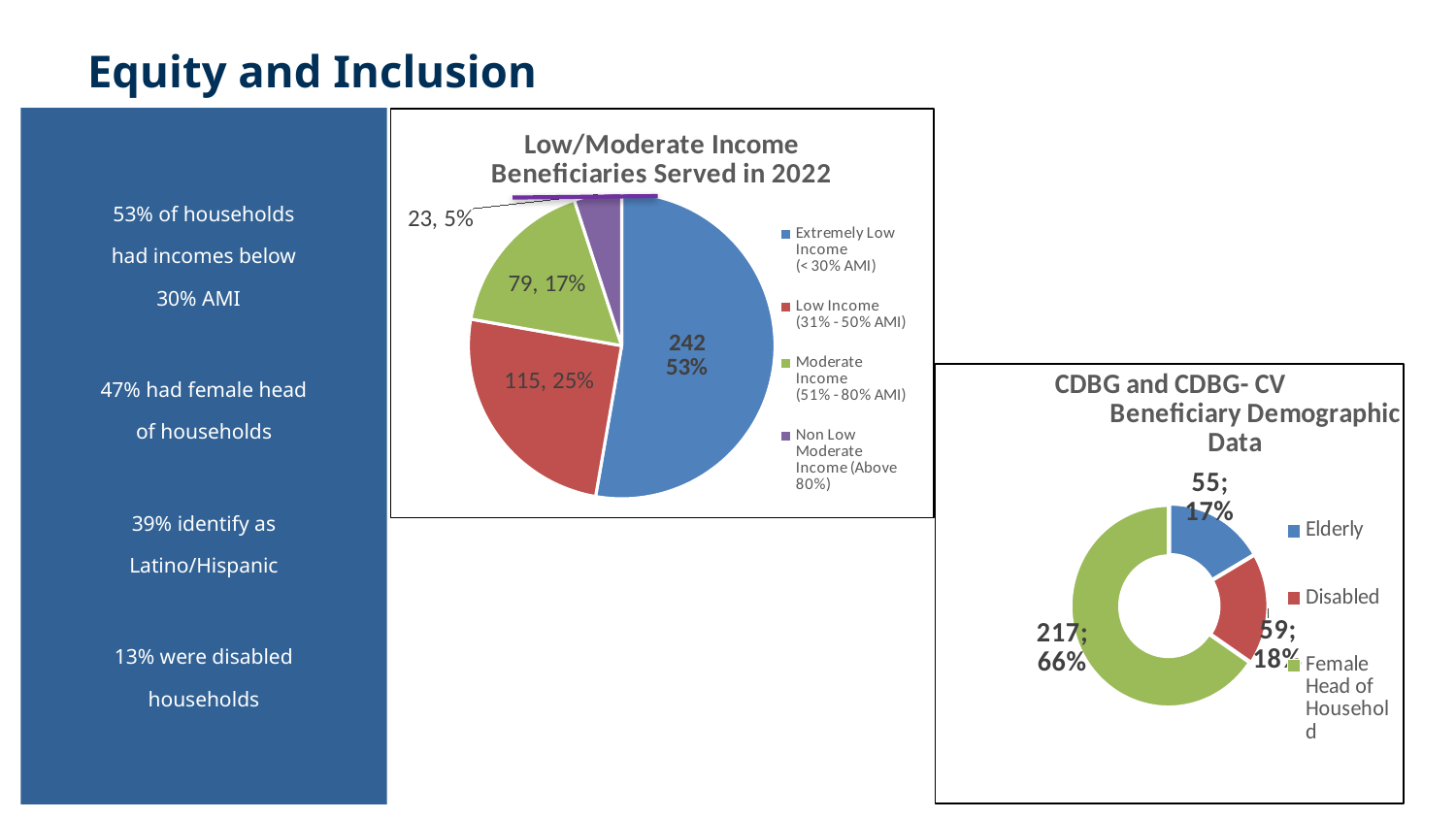
In the 'Low/Moderate Income Beneficiaries Served in 2022' chart, how many beneficiaries were Extremely Low Income (< 30% AMI)? 242 In the 'CDBG and CDBG-CV Beneficiary Demographic Data' chart, what percentage of beneficiaries are Elderly? 17% In the 'Low/Moderate Income Beneficiaries Served in 2022' chart, what is the difference between the number of Extremely Low Income and Low Income beneficiaries? 127 In the 'Low/Moderate Income Beneficiaries Served in 2022' chart, how many beneficiaries were Moderate Income (51% - 80% AMI)? 79 In the 'Low/Moderate Income Beneficiaries Served in 2022' chart, which income category has the smallest slice? Non Low Moderate Income (Above 80%) In the 'CDBG and CDBG-CV Beneficiary Demographic Data' chart, how many beneficiaries are Female Head of Household? 217 What type of chart is the 'Low/Moderate Income Beneficiaries Served in 2022' chart? Pie chart In the 'CDBG and CDBG-CV Beneficiary Demographic Data' chart, what is the difference between the Disabled and Elderly counts? 4 How many categories does the legend of the 'Low/Moderate Income Beneficiaries Served in 2022' chart list? 4 In the 'Low/Moderate Income Beneficiaries Served in 2022' chart, which income category has the largest slice? Extremely Low Income (< 30% AMI) In the 'Low/Moderate Income Beneficiaries Served in 2022' chart, what percentage of beneficiaries were Low Income (31% - 50% AMI)? 25% In the 'CDBG and CDBG-CV Beneficiary Demographic Data' chart, which category has the largest share? Female Head of Household